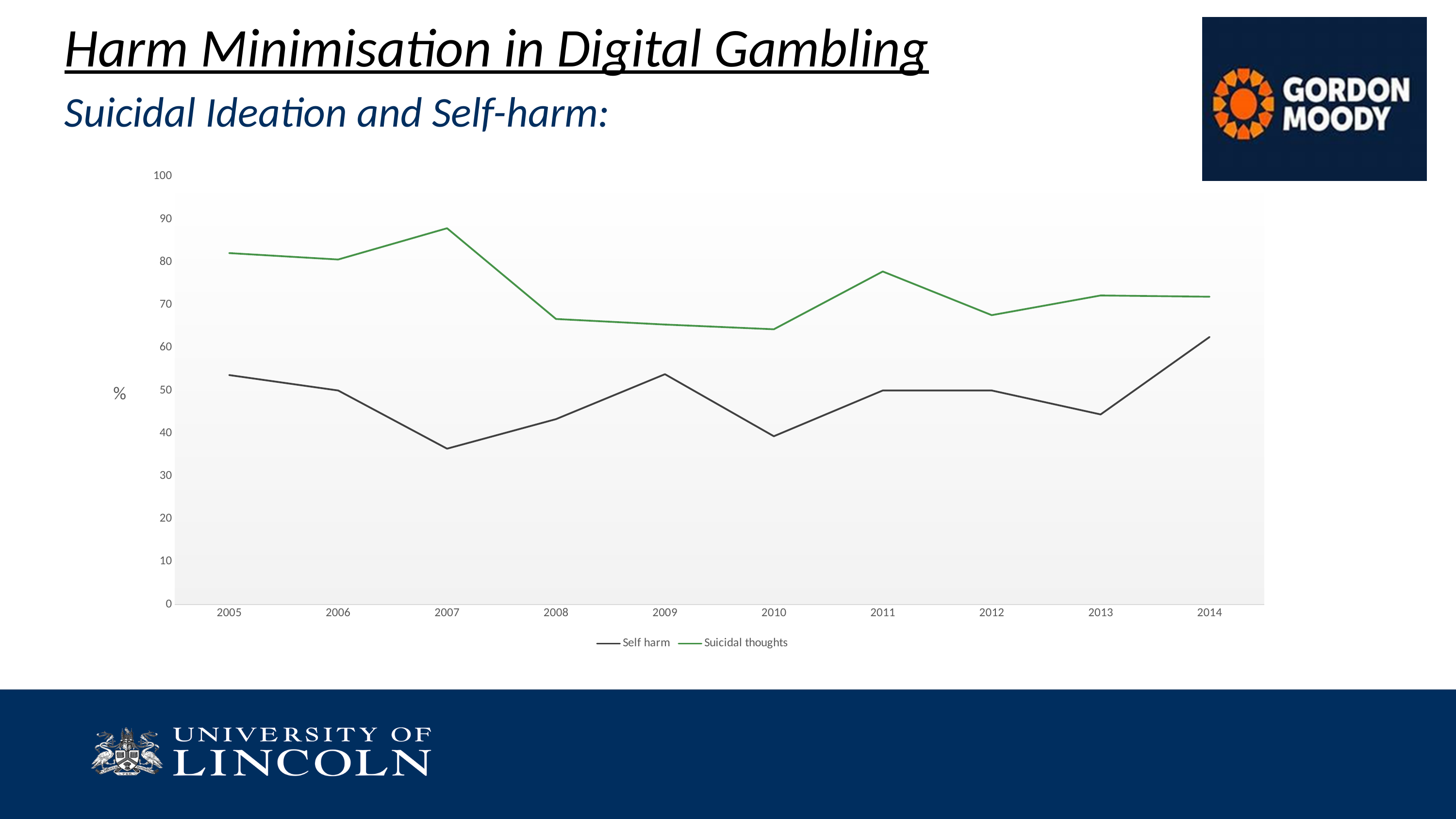
In which year is the Suicidal thoughts value highest? 2007 In which year is the Self harm value lowest? 2007 Is the Self harm value for 2014 greater or less than 60? greater Is the Suicidal thoughts value for 2007 greater or less than 80? greater How many years are shown along the x axis? 10 Which is larger, the Suicidal thoughts value for 2005 or for 2008? 2005 Is the Self harm value for 2007 greater or less than 40? less What kind of chart is shown on the slide? line chart In which year is the Self harm value highest? 2014 How many series does the legend list? 2 Does the Suicidal thoughts line rise or fall from 2007 to 2008? fall